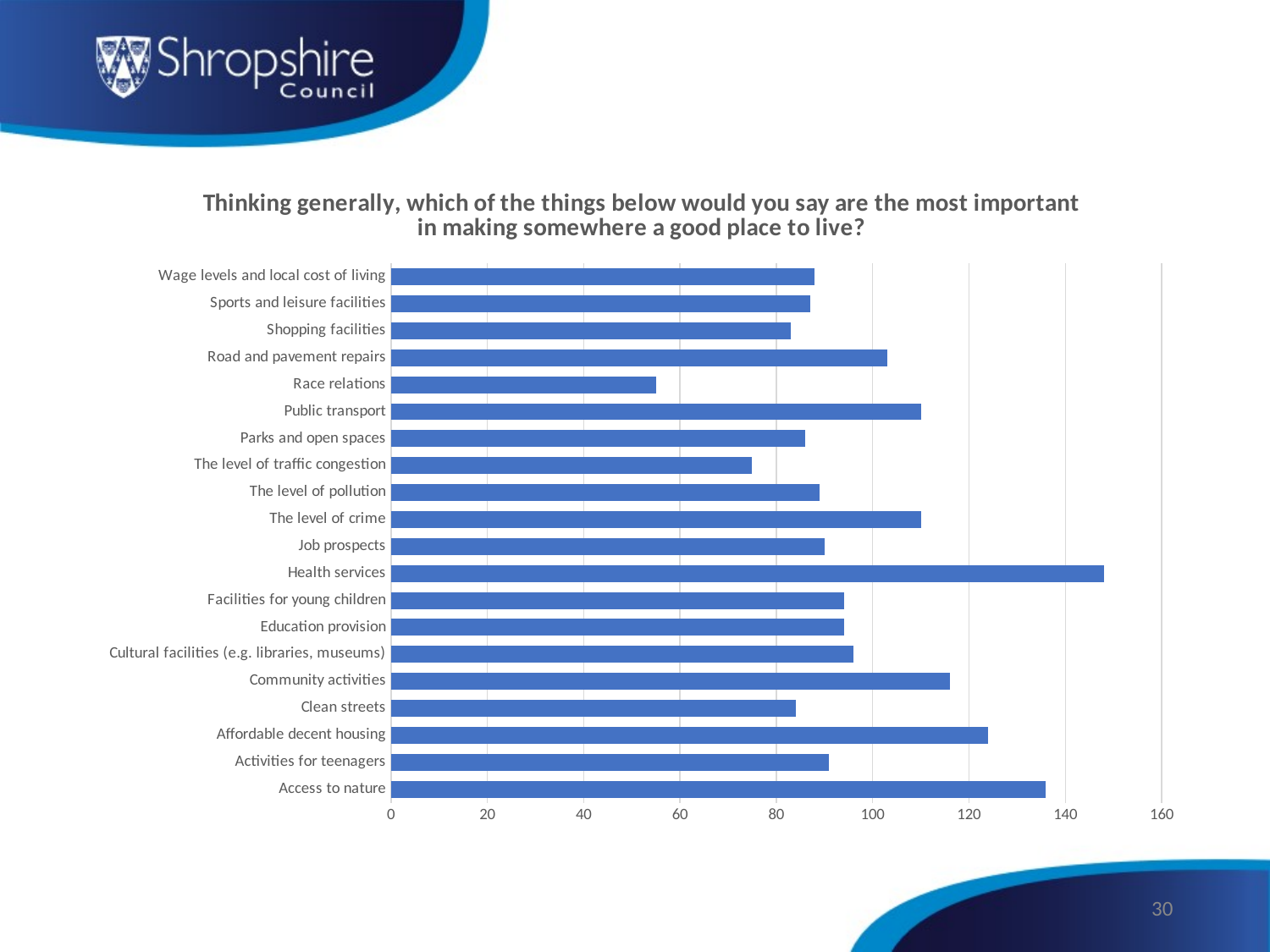
Which category has the lowest value in the chart? Race relations What kind of chart is shown on the slide? Bar chart Which category has the highest value in the chart? Health services What is the title of the chart? Thinking generally, which of the things below would you say are the most important in making somewhere a good place to live? Is the value for Health services greater or less than 140? greater Is the value for Access to nature greater or less than 120? greater Which is larger, the value for Access to nature or the value for Affordable decent housing? Access to nature Is the value for Race relations greater or less than 60? less Which is larger, the value for Public transport or the value for Parks and open spaces? Public transport How many categories are plotted in the chart? 20